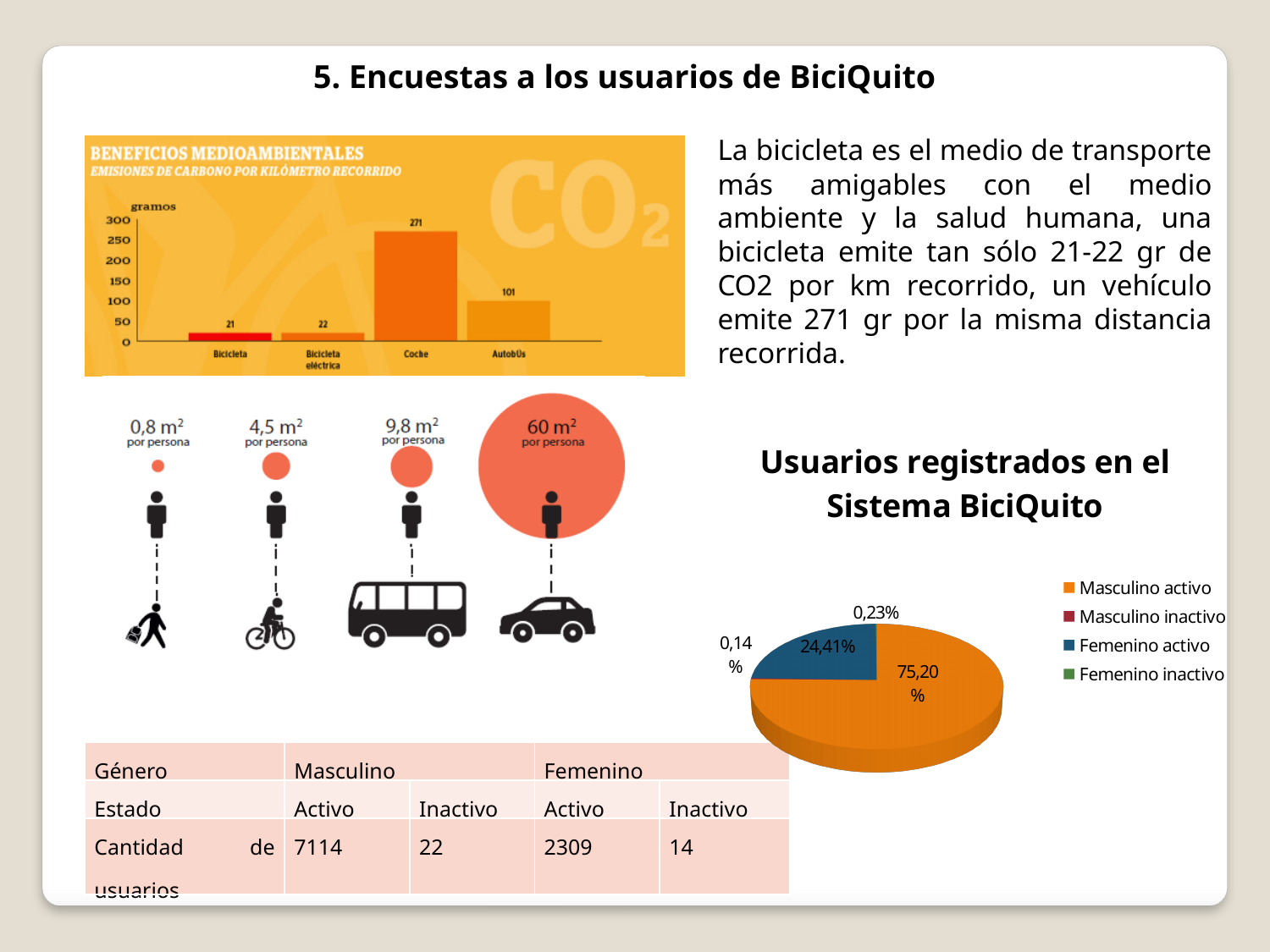
What kind of chart is 'Beneficios medioambientales'? Bar chart In the bar chart 'Beneficios medioambientales', which category has the lowest emissions? Bicicleta In the pie chart 'Usuarios registrados en el Sistema BiciQuito', which is larger, Masculino activo or Femenino activo? Masculino activo In the bar chart 'Beneficios medioambientales', how many categories are shown? 4 In the bar chart 'Beneficios medioambientales', which category has the highest emissions? Coche In the pie chart 'Usuarios registrados en el Sistema BiciQuito', what share is Masculino activo? 75,20% In the bar chart 'Beneficios medioambientales', what is the value for Autobús? 101 In the pie chart 'Usuarios registrados en el Sistema BiciQuito', how many entries does the legend list? 4 In the bar chart 'Beneficios medioambientales', what is the difference between the values for Coche and Autobús? 170 In the bar chart 'Beneficios medioambientales', what is the value for Bicicleta? 21 In the pie chart 'Usuarios registrados en el Sistema BiciQuito', what share is Femenino activo? 24,41% In the bar chart 'Beneficios medioambientales', what is the value for Coche? 271